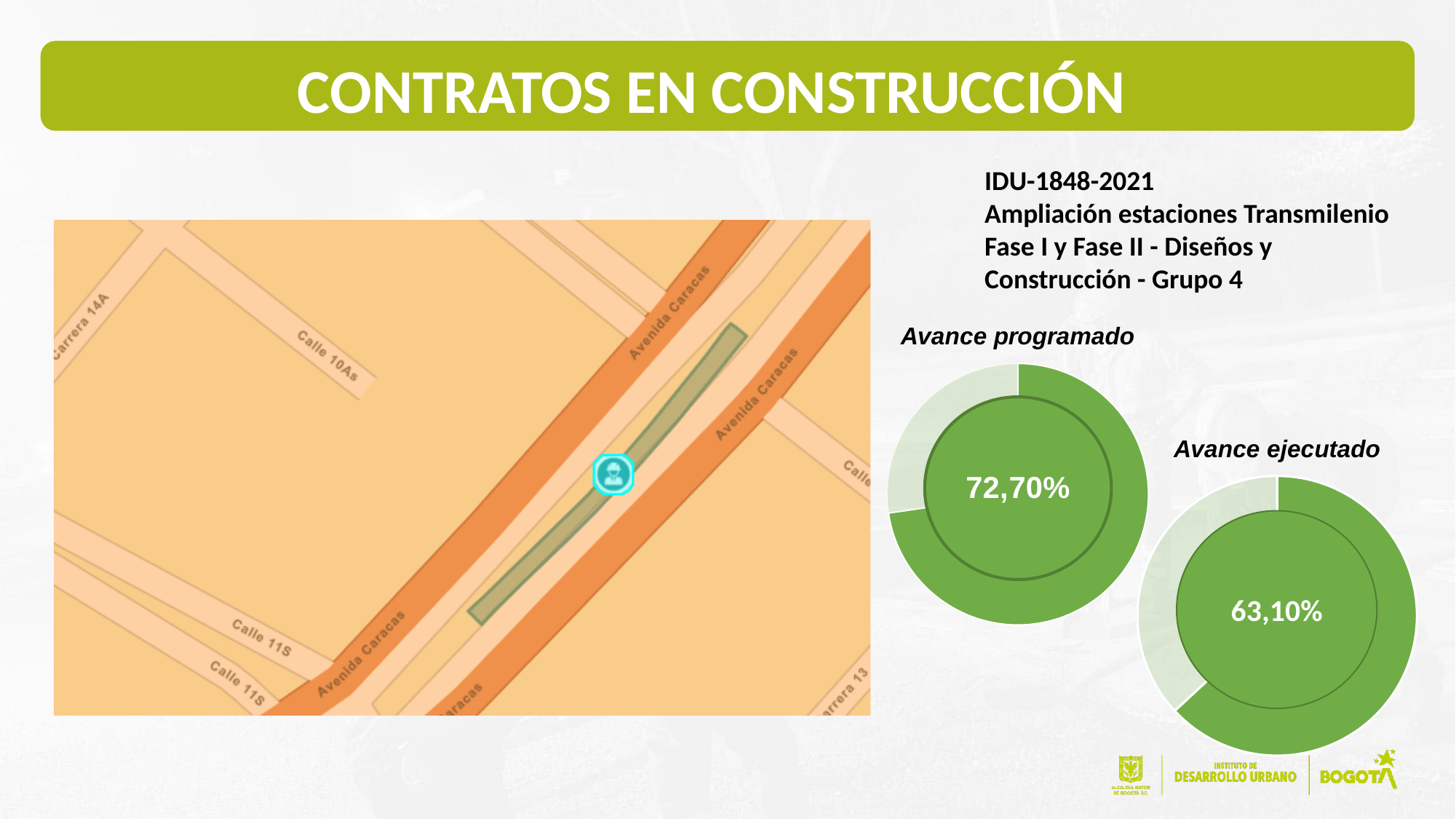
What value is shown in the centre of the 'Avance ejecutado' chart? 63,10% What is the title of the chart on the right, below the 'Avance programado' chart? Avance ejecutado In the 'Avance ejecutado' chart, is the dark green portion greater or less than 50%? greater What contract number is shown above the charts? IDU-1848-2021 In the 'Avance programado' chart, is the dark green portion greater or less than 50%? greater In the 'Avance ejecutado' chart, what share of the pie does the light green (remaining) slice represent? 36,90% What kind of chart is used to show 'Avance programado'? Pie chart (donut) What value is shown in the centre of the 'Avance programado' chart? 72,70% Which is larger, the 'Avance programado' value or the 'Avance ejecutado' value? Avance programado How many charts are shown on the slide? 2 In the 'Avance programado' chart, what share of the pie does the light green (remaining) slice represent? 27,30% What is the difference between the 'Avance programado' value and the 'Avance ejecutado' value? 9,60%